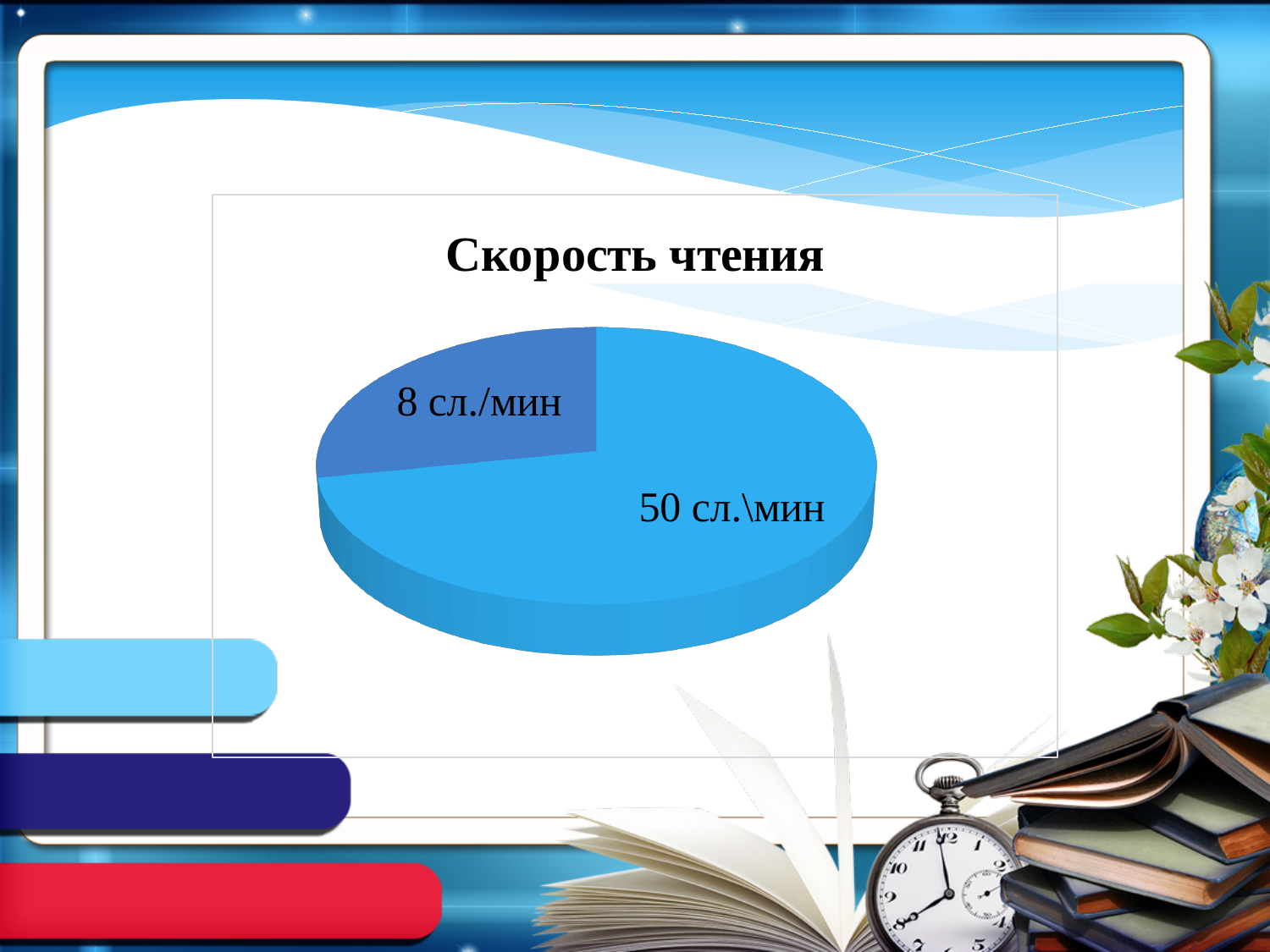
What is the difference between the two values shown on the pie chart, 50 and 8? 42 What is the label on the smaller slice of the pie chart? 8 сл./мин What is the title of the chart? Скорость чтения What is the label on the larger slice of the pie chart? 50 сл.\мин Which slice is larger: the one labelled 8 сл./мин or the one labelled 50 сл.\мин? 50 сл.\мин Which slice is shown in the darker blue colour? 8 сл./мин What kind of chart is shown on the slide? pie chart What is the total of the two values shown on the pie chart? 58 How many slices does the pie chart have? 2